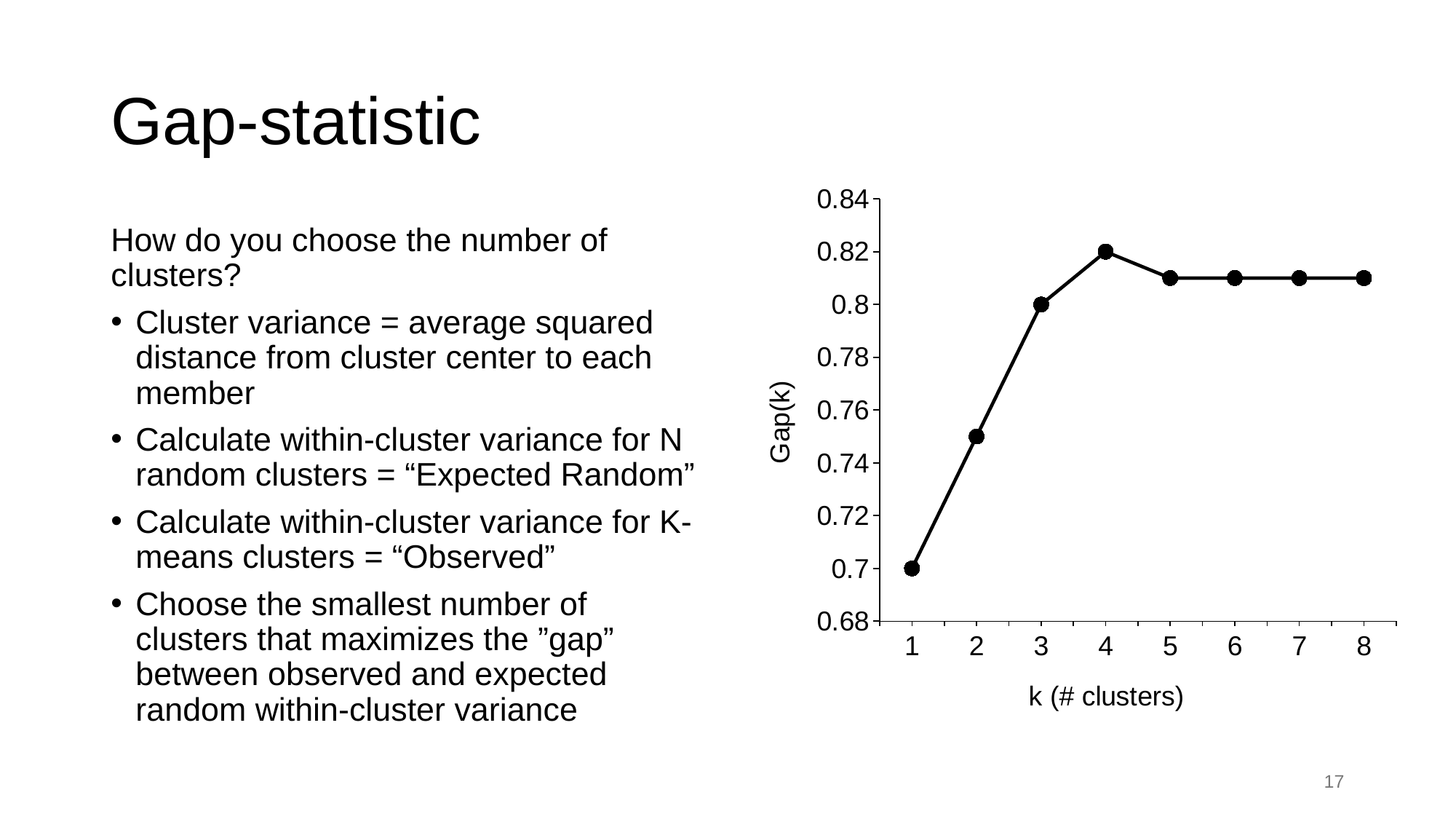
What type of chart is shown on the slide? line chart At which value of k is Gap(k) lowest? 1 What is the difference between Gap(k) at k = 4 and at k = 1? 0.12 Is the value of Gap(k) at k = 2 greater or less than 0.74? greater Does Gap(k) rise or fall from k = 1 to k = 4? rise What is the value of Gap(k) at k = 1? 0.7 What is the value of Gap(k) at k = 4? 0.82 How many data points are plotted on the chart? 8 What is the value of Gap(k) at k = 3? 0.8 Is the value of Gap(k) at k = 5 greater or less than 0.82? less What is the label of the x axis? k (# clusters) At which value of k is Gap(k) highest? 4